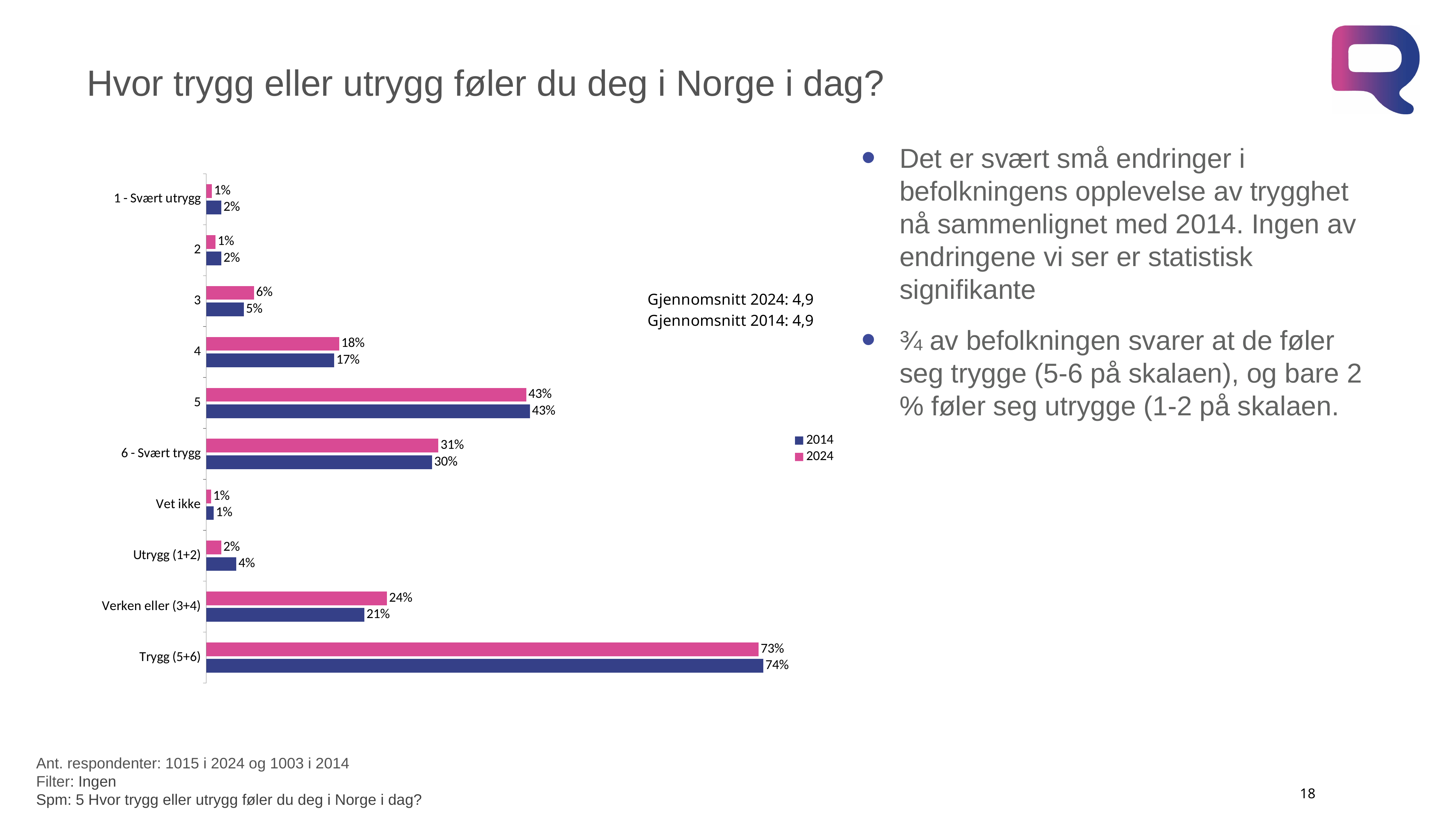
Which category has the highest 2014 value? Trygg (5+6) Which is larger for "Utrygg (1+2)": the 2014 value or the 2024 value? 2014 What is the difference between the 2024 and 2014 values for "Verken eller (3+4)"? 3% What kind of chart is shown on the slide? bar chart What is the difference between the 2014 and 2024 values for "1 - Svært utrygg"? 1% Which colour represents the 2024 series in the chart? pink How many series does the chart legend list? 2 How many categories are shown on the chart? 10 What is the 2014 value for "6 - Svært trygg"? 30% What is the 2014 value for "Utrygg (1+2)"? 4% What is the 2024 value for category "4"? 18% What is the 2024 value for "Trygg (5+6)"? 73%